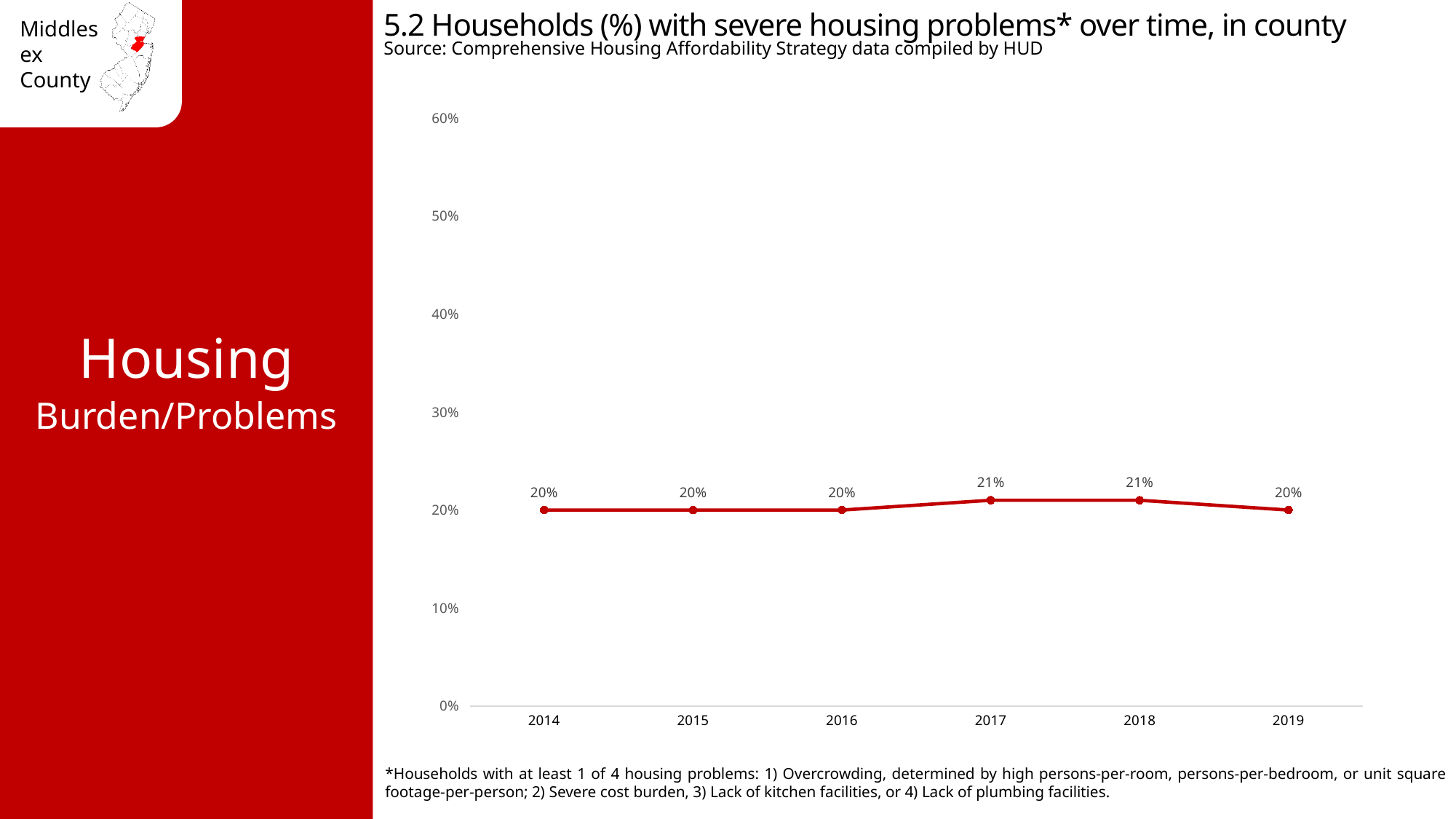
What percentage of households had severe housing problems in 2014? 20% How many years are plotted on the x axis? 6 What percentage of households had severe housing problems in 2017? 21% What is the title of the chart? 5.2 Households (%) with severe housing problems* over time, in county What is the value shown for 2018? 21% Is the value for 2018 greater or less than 10%? greater What percentage of households had severe housing problems in 2019? 20% Which years show the highest value on the chart? 2017 and 2018 What is the difference between the 2017 value and the 2016 value? 1% What kind of chart is shown on the slide? line chart What is the highest value shown on the y axis? 60% Is the value for 2015 greater or less than 30%? less